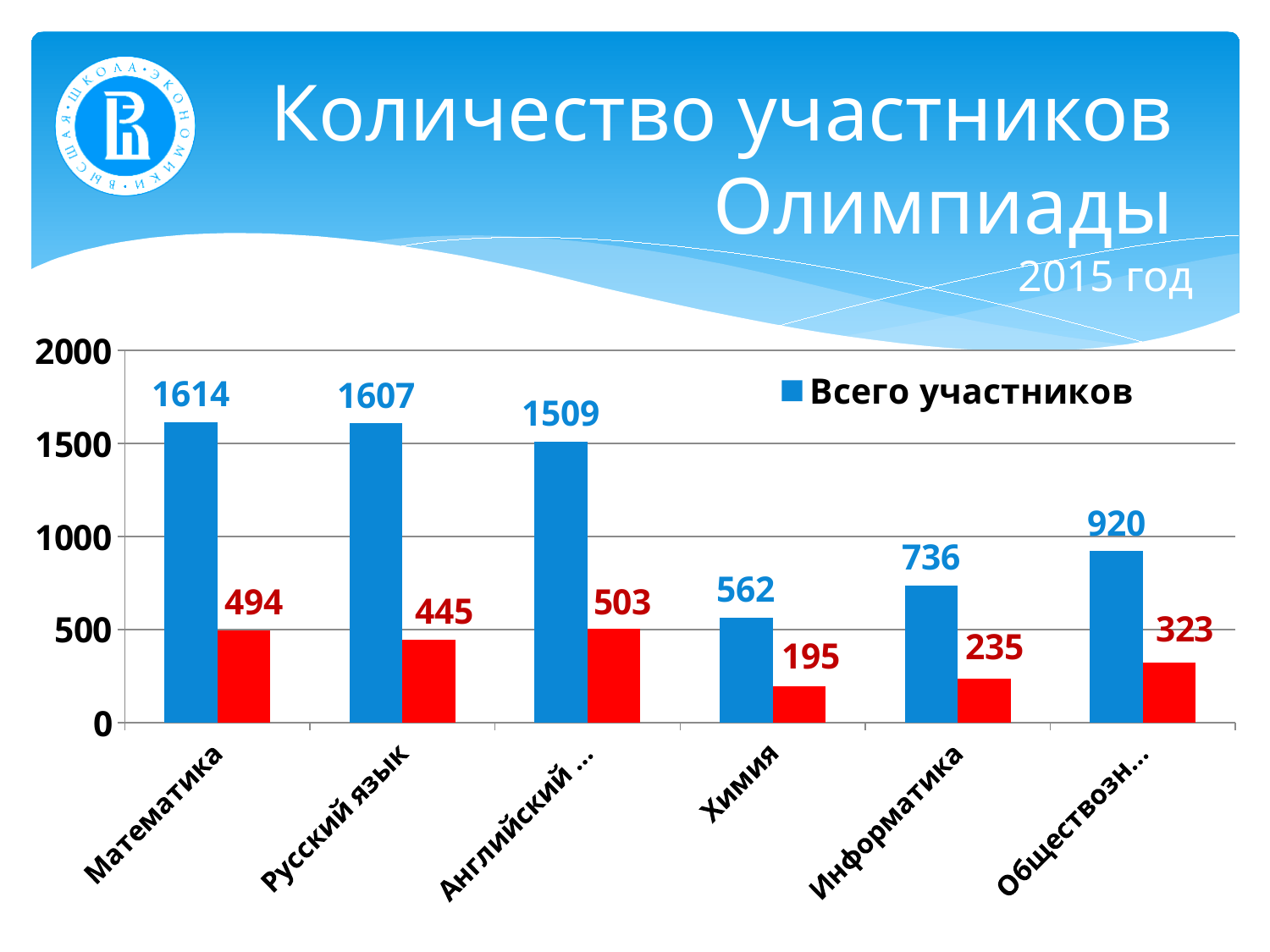
What is the value of Всего участников for Математика? 1614 How many categories are shown on the x axis? 6 Which category has the lowest value for Всего участников? Химия Is the Всего участников value for Информатика greater or less than 500? greater Which is larger, the Всего участников value for Информатика or for Химия? Информатика What is the value of the red bar for Русский язык? 445 What is the difference between the red bar values for Информатика and Химия? 40 Which category has the lowest red bar? Химия What is the difference between the Всего участников value and the red bar value for Математика? 1120 Which category has the highest value for Всего участников? Математика What is the value of the red bar for Химия? 195 How many series does the legend list? 1